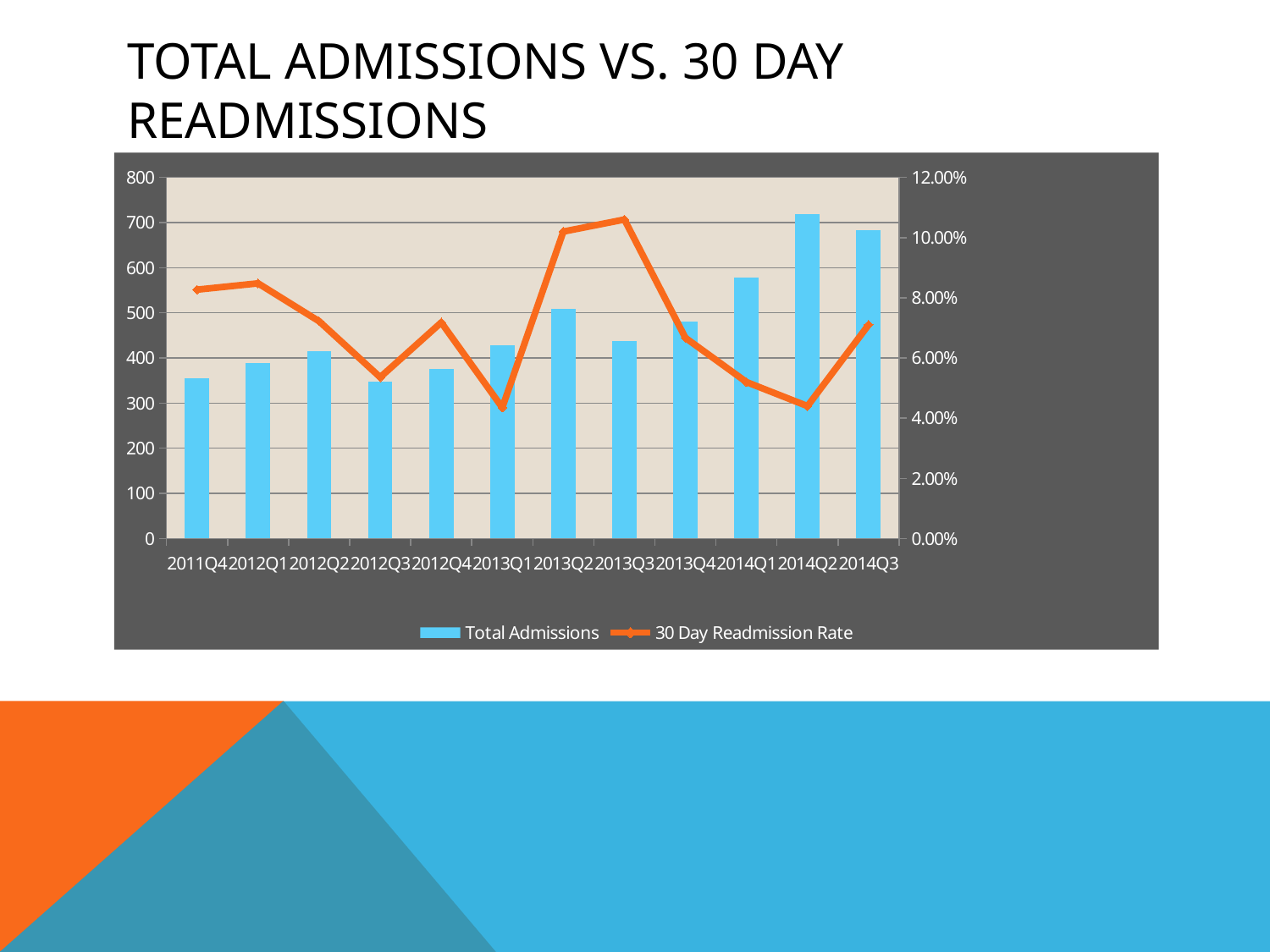
How many quarters are shown on the x axis of the chart? 12 Which series is plotted as the orange line in the chart? 30 Day Readmission Rate Which quarter has a higher 30 Day Readmission Rate, 2012Q1 or 2012Q3? 2012Q1 Is the Total Admissions value for 2011Q4 greater or less than 400? less How many series does the chart's legend list? 2 Is the 30 Day Readmission Rate for 2013Q1 greater or less than 6.00%? less Which quarter has the highest Total Admissions? 2014Q2 Is the Total Admissions value for 2014Q1 greater or less than 500? greater Which quarter has higher Total Admissions, 2013Q4 or 2014Q1? 2014Q1 What kind of chart is shown on the slide? A combination bar and line chart